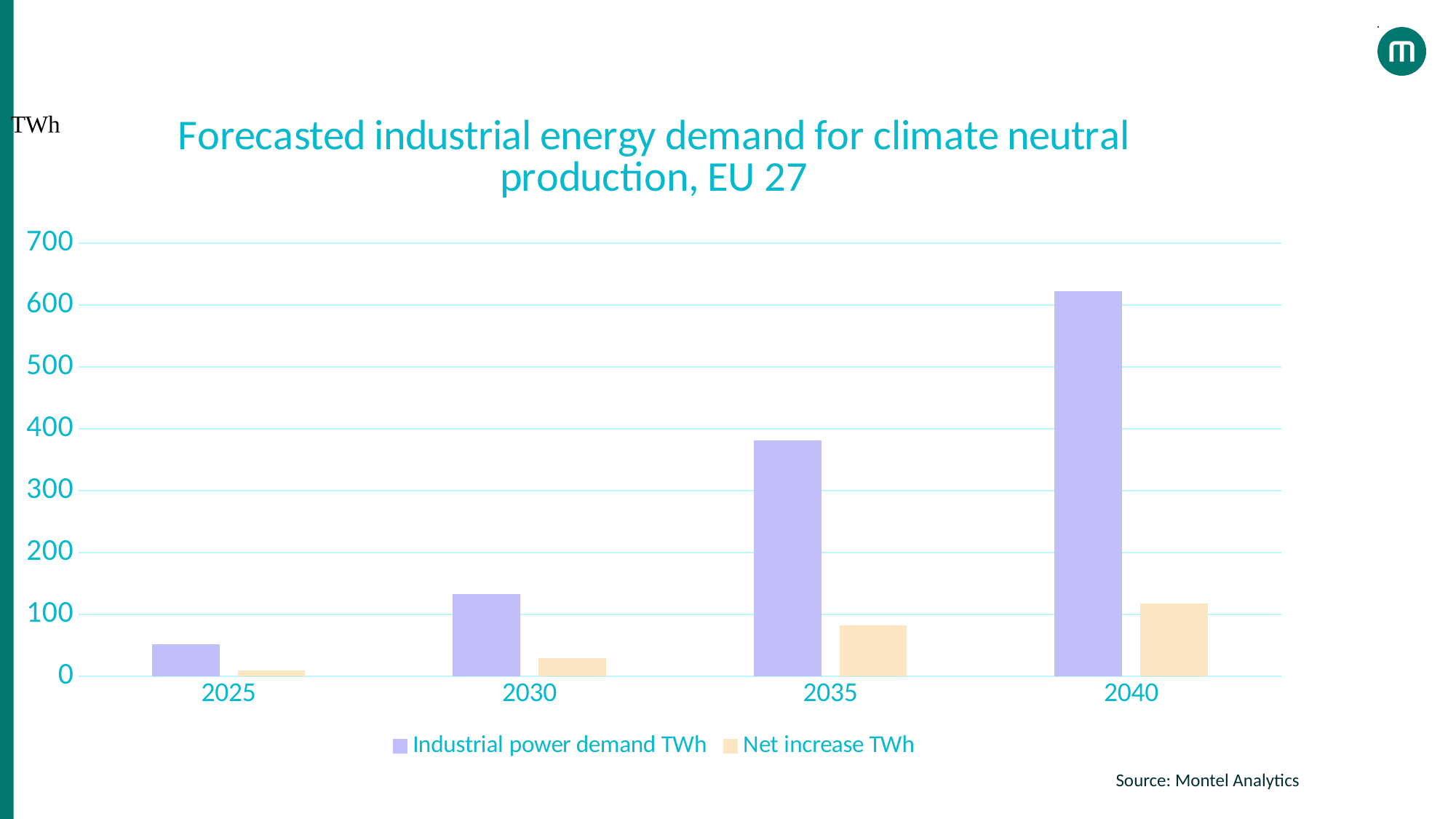
Is the Industrial power demand TWh for 2030 greater or less than 100? greater Is the Net increase TWh for 2040 greater or less than 100? greater Do the Industrial power demand TWh values rise or fall from 2025 to 2040? rise Is the Industrial power demand TWh for 2035 greater or less than 400? less Which year has the highest Industrial power demand TWh? 2040 Which is larger in 2035: Industrial power demand TWh or Net increase TWh? Industrial power demand TWh What type of chart is shown on the slide? bar chart Which year has the lowest Net increase TWh? 2025 What is the title of the chart? Forecasted industrial energy demand for climate neutral production, EU 27 How many series does the legend list? 2 How many years are shown on the x axis? 4